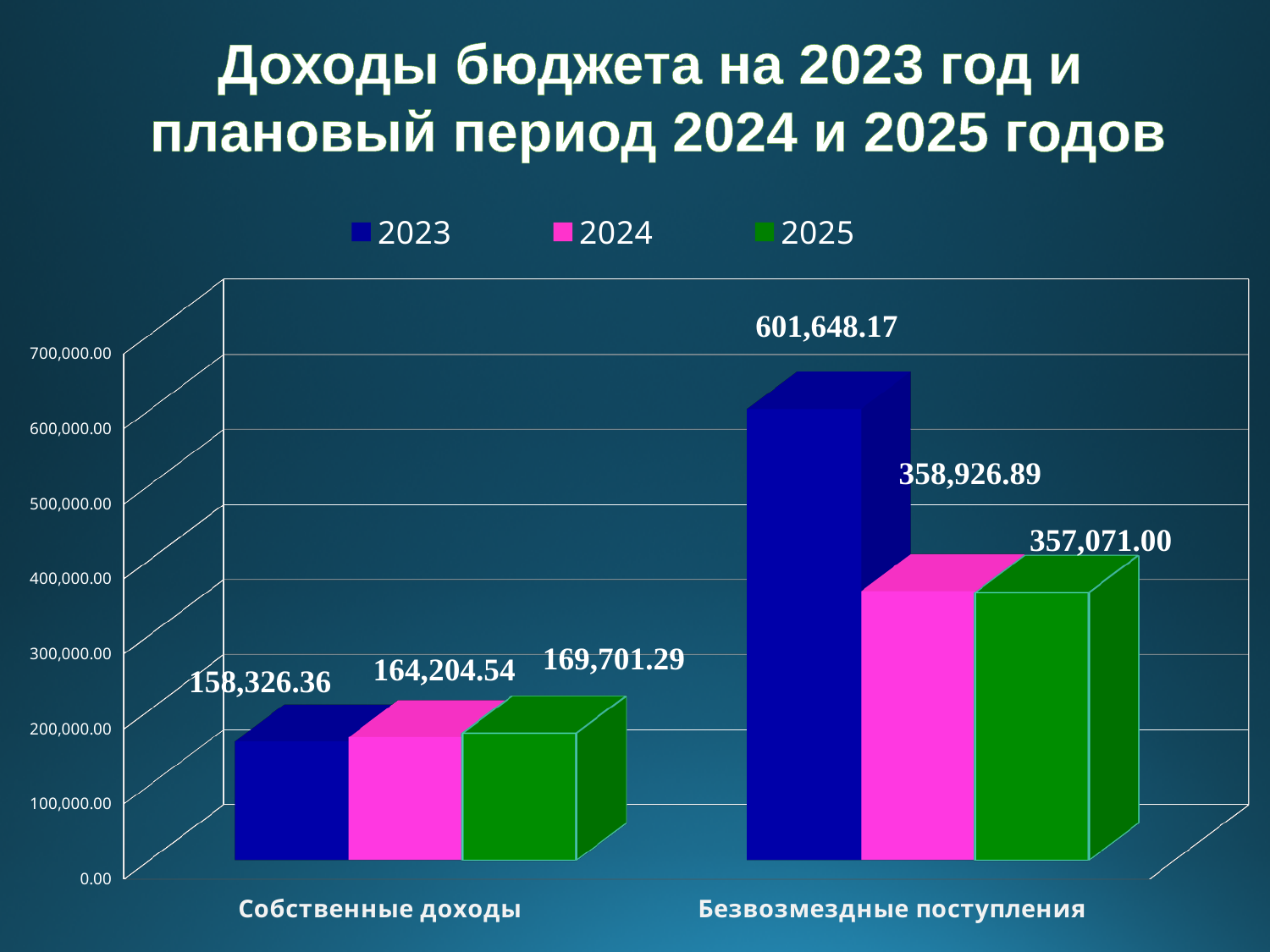
Is the 2023 value for Безвозмездные поступления greater or less than 500,000.00? greater Which year has the highest value in the Безвозмездные поступления category? 2023 What is the difference between the 2025 and 2023 values in the Собственные доходы category? 11,374.93 How many series does the legend list? 3 What is the value for 2024 in the Безвозмездные поступления category? 358,926.89 What is the value for 2023 in the Безвозмездные поступления category? 601,648.17 What kind of chart is shown on the slide? bar chart What is the value for 2023 in the Собственные доходы category? 158,326.36 Which year has the lowest value in the Собственные доходы category? 2023 What is the value for 2025 in the Собственные доходы category? 169,701.29 What is the difference between the 2023 and 2024 values in the Безвозмездные поступления category? 242,721.28 Which is larger: the 2023 value for Собственные доходы or the 2023 value for Безвозмездные поступления? Безвозмездные поступления